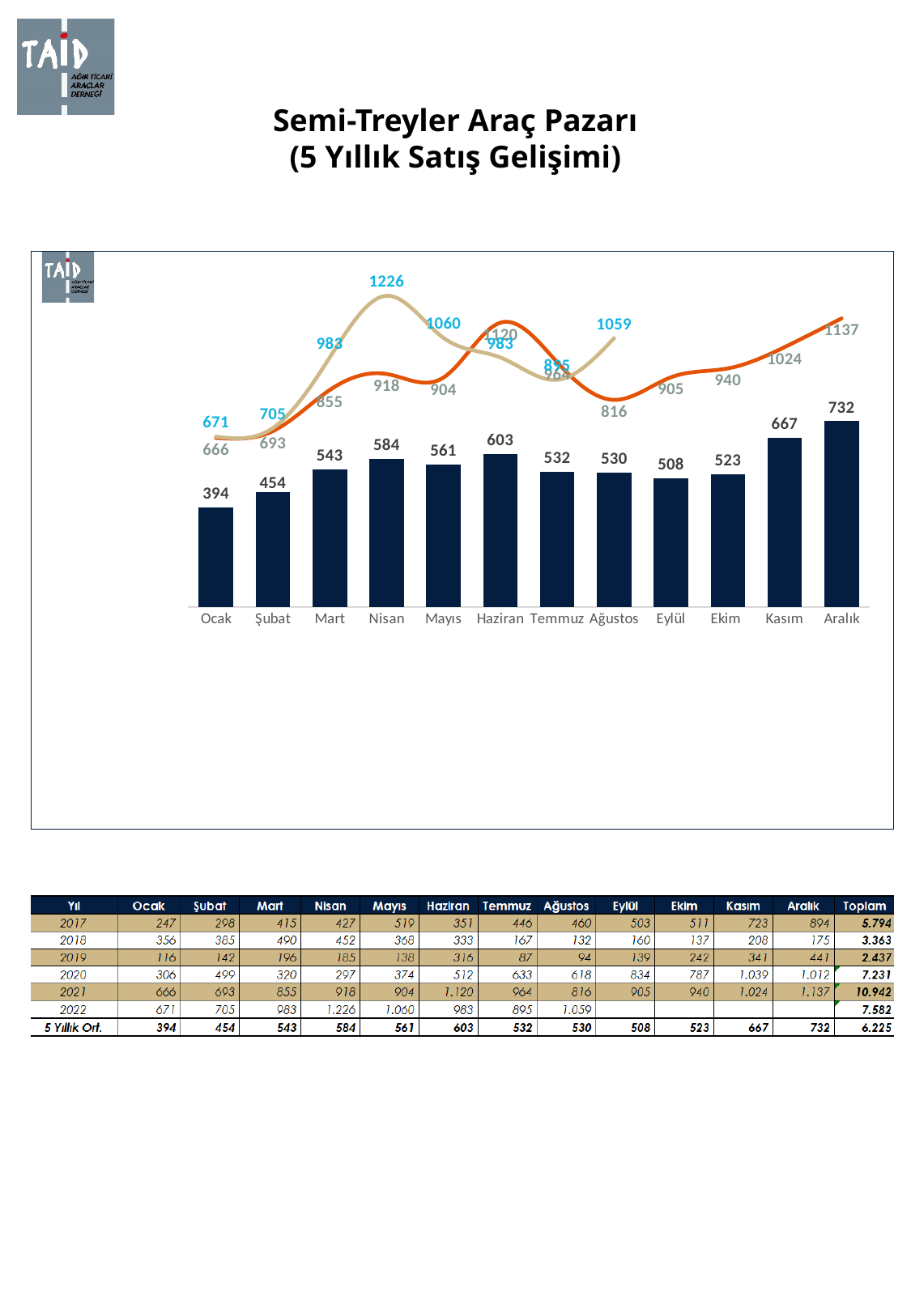
What is the value of the bar for Aralık? 732 Which month has the shortest bar? Ocak What is the difference between the bar values for Kasım and Ekim? 144 Which month has the tallest bar? Aralık Which bar is taller, Nisan or Mayıs? Nisan What is the value labelled on the grey line for Aralık? 1137 What is the title of the slide? Semi-Treyler Araç Pazarı (5 Yıllık Satış Gelişimi) What is the highest value labelled on the light blue line? 1226 How many months are shown on the x axis of the chart? 12 What is the value of the bar for Haziran? 603 What kind of chart is shown on the slide? Combined bar and line chart Do the bar values rise or fall from Eylül to Aralık? rise